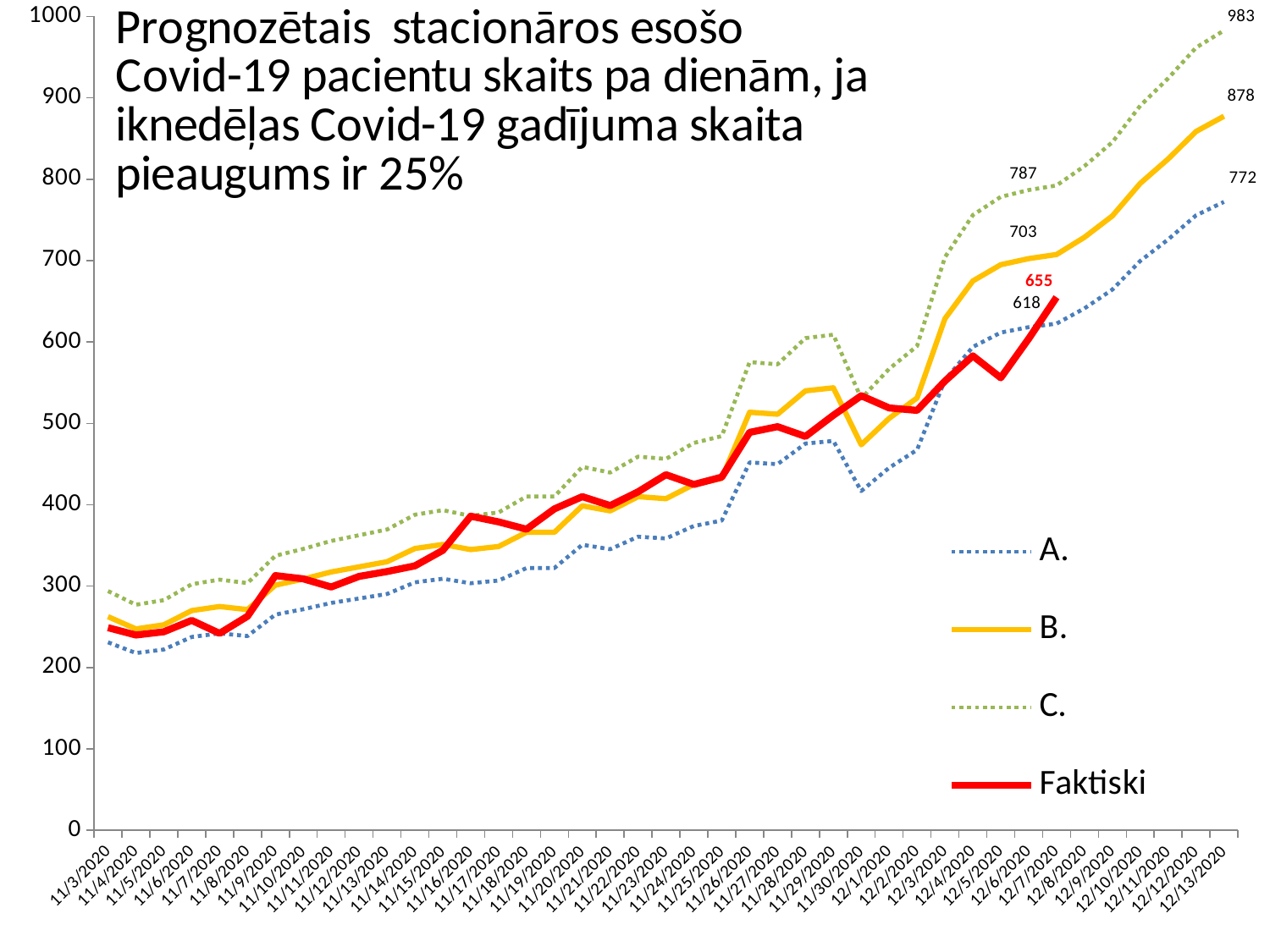
What is the difference between series C. and series B. on 12/13/2020? 105 Which series has the highest value on 12/13/2020? C. What is the Faktiski value on 12/7/2020? 655 What is the value of series A. on 12/13/2020? 772 How many series does the legend list? 4 What is the value of series B. on 12/13/2020? 878 Is the Faktiski value on 11/3/2020 greater or less than 300? less Which is larger on 12/7/2020, series B. or Faktiski? B. What is the value of series C. on 12/13/2020? 983 What kind of chart is shown on the slide? Line chart Do the values of series C. rise or fall from 11/3/2020 to 12/13/2020? Rise